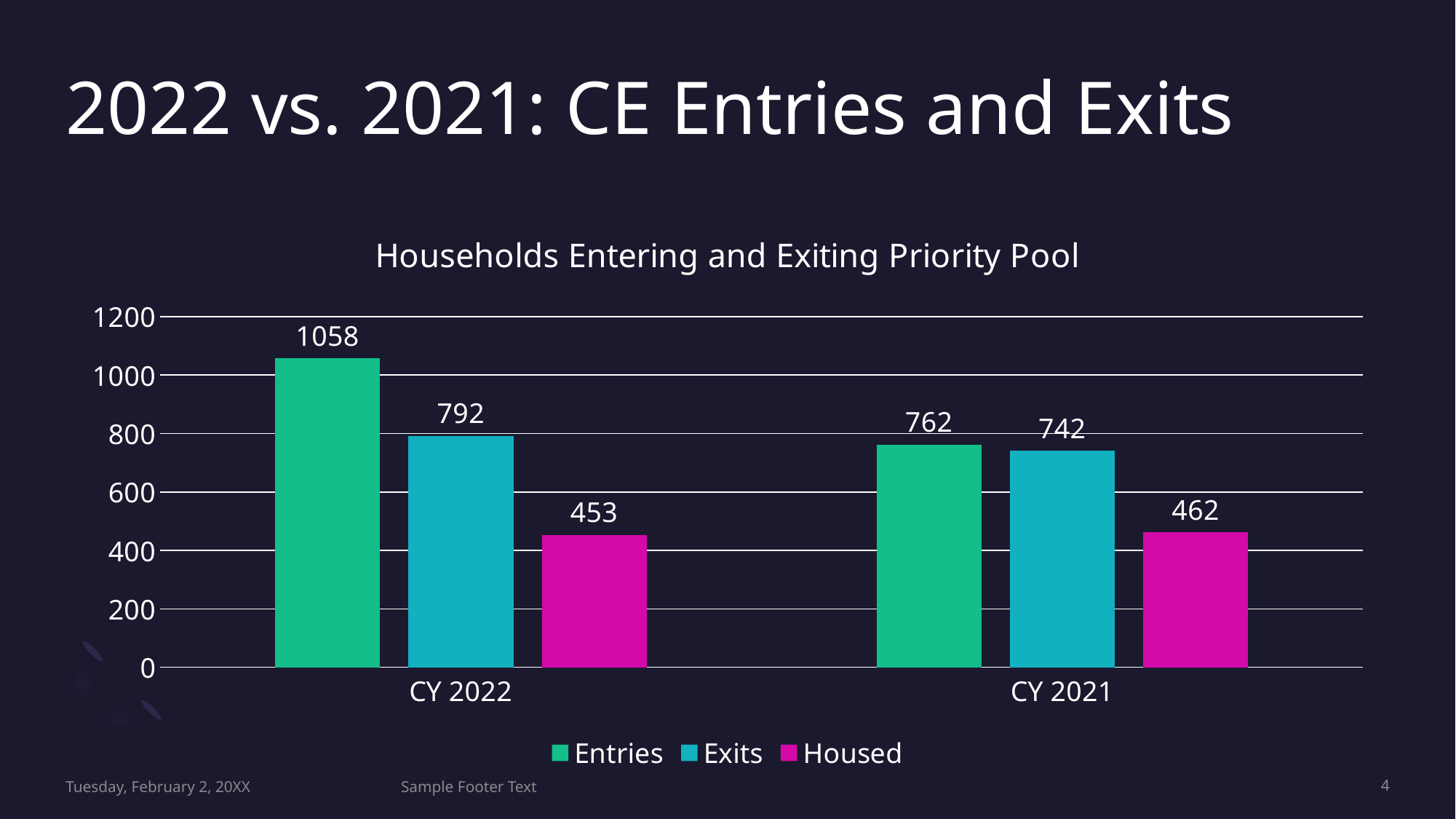
How many series does the legend list? 3 Which series has the lowest value in CY 2021? Housed What is the title of the chart? Households Entering and Exiting Priority Pool What is the value for Housed in CY 2021? 462 Which is larger: Exits in CY 2022 or Exits in CY 2021? Exits in CY 2022 What is the value for Entries in CY 2022? 1058 What kind of chart is shown on the slide? bar chart Is the value for Entries in CY 2021 greater or less than 800? less Which series has the highest value in CY 2022? Entries What is the value for Exits in CY 2022? 792 What is the difference between Entries in CY 2022 and Entries in CY 2021? 296 What is the difference between Exits and Housed in CY 2022? 339